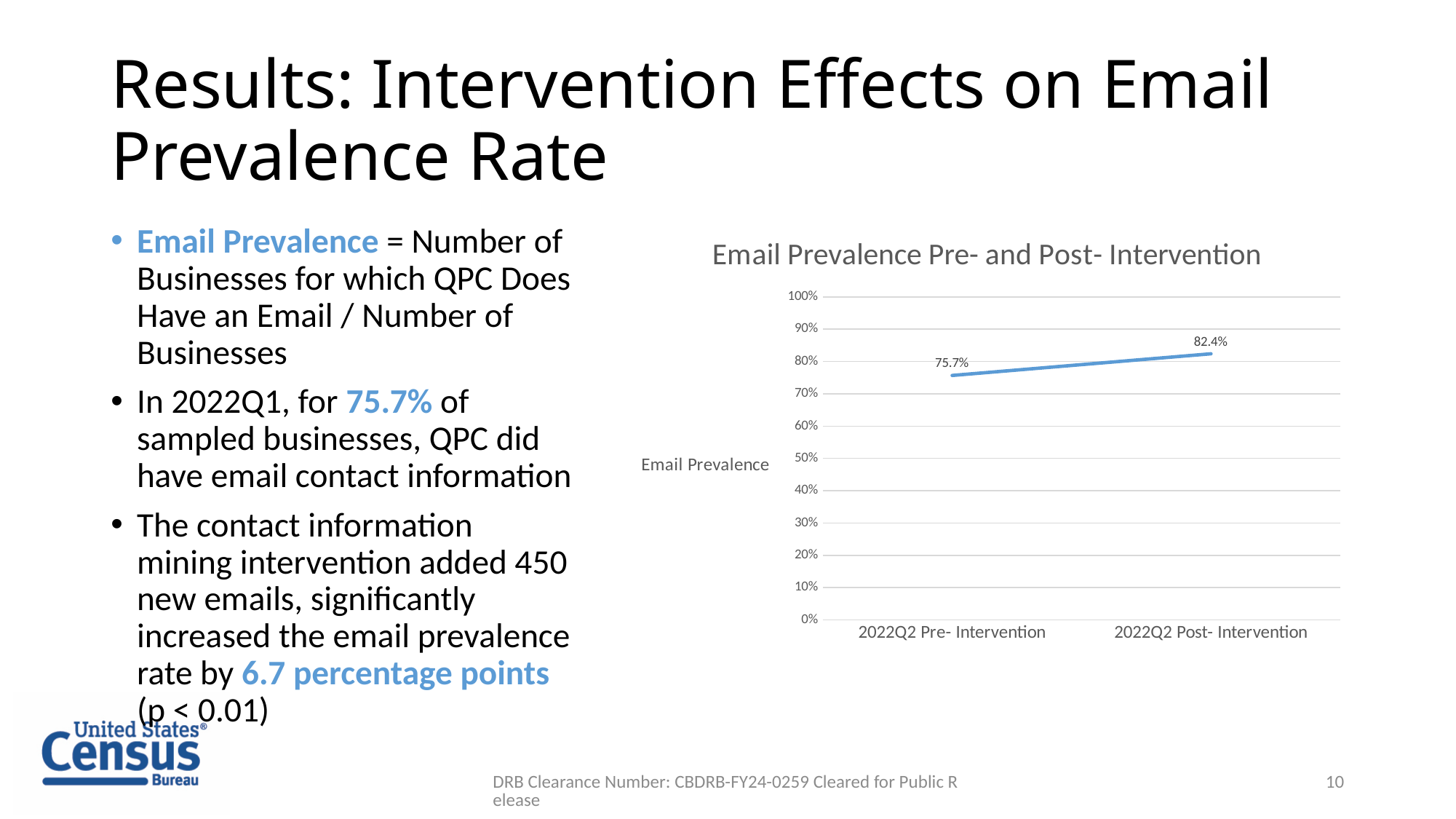
Which category has the lowest email prevalence value? 2022Q2 Pre- Intervention How many data points are plotted on the chart? 2 Which point has the higher email prevalence, Pre- Intervention or Post- Intervention? 2022Q2 Post- Intervention What is the label on the vertical axis of the chart? Email Prevalence What is the title of the chart? Email Prevalence Pre- and Post- Intervention What is the email prevalence value for 2022Q2 Pre- Intervention? 75.7% What is the email prevalence value for 2022Q2 Post- Intervention? 82.4% Does the email prevalence rise or fall from Pre- Intervention to Post- Intervention? rise What is the difference in percentage points between the Post- Intervention and Pre- Intervention values? 6.7 What kind of chart is shown on the slide? line chart Is the value for 2022Q2 Pre- Intervention greater or less than 80%? less Is the value for 2022Q2 Post- Intervention greater or less than 80%? greater